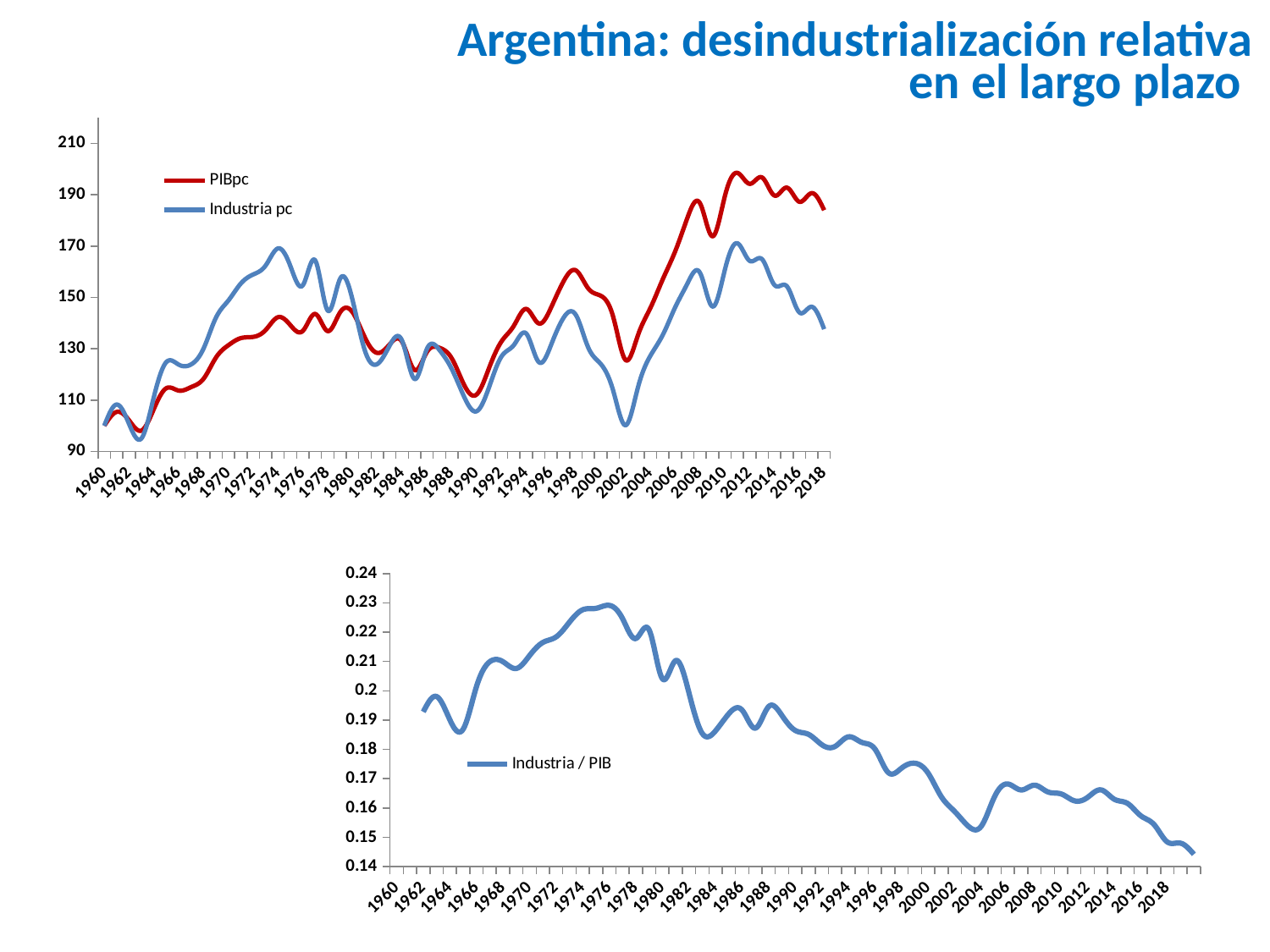
In the top chart, does the PIBpc series overall rise or fall from 1960 to 2018? rise What series name does the legend of the bottom chart show? Industria / PIB In the top chart, is the value of PIBpc in 2018 greater or less than 170? greater In the bottom chart, is the value of Industria / PIB in 2018 greater or less than 0.16? less In the top chart, which series has the higher value in 2018, PIBpc or Industria pc? PIBpc What kind of chart is the top chart on the slide? line chart How many series does the legend of the top chart list? 2 In the top chart, which series has the higher value in 1974, PIBpc or Industria pc? Industria pc In the bottom chart, does the Industria / PIB series overall rise or fall from 1976 to 2018? fall In the top chart, is the value of Industria pc in 2002 greater or less than 110? less In the top chart, which series is drawn in red? PIBpc